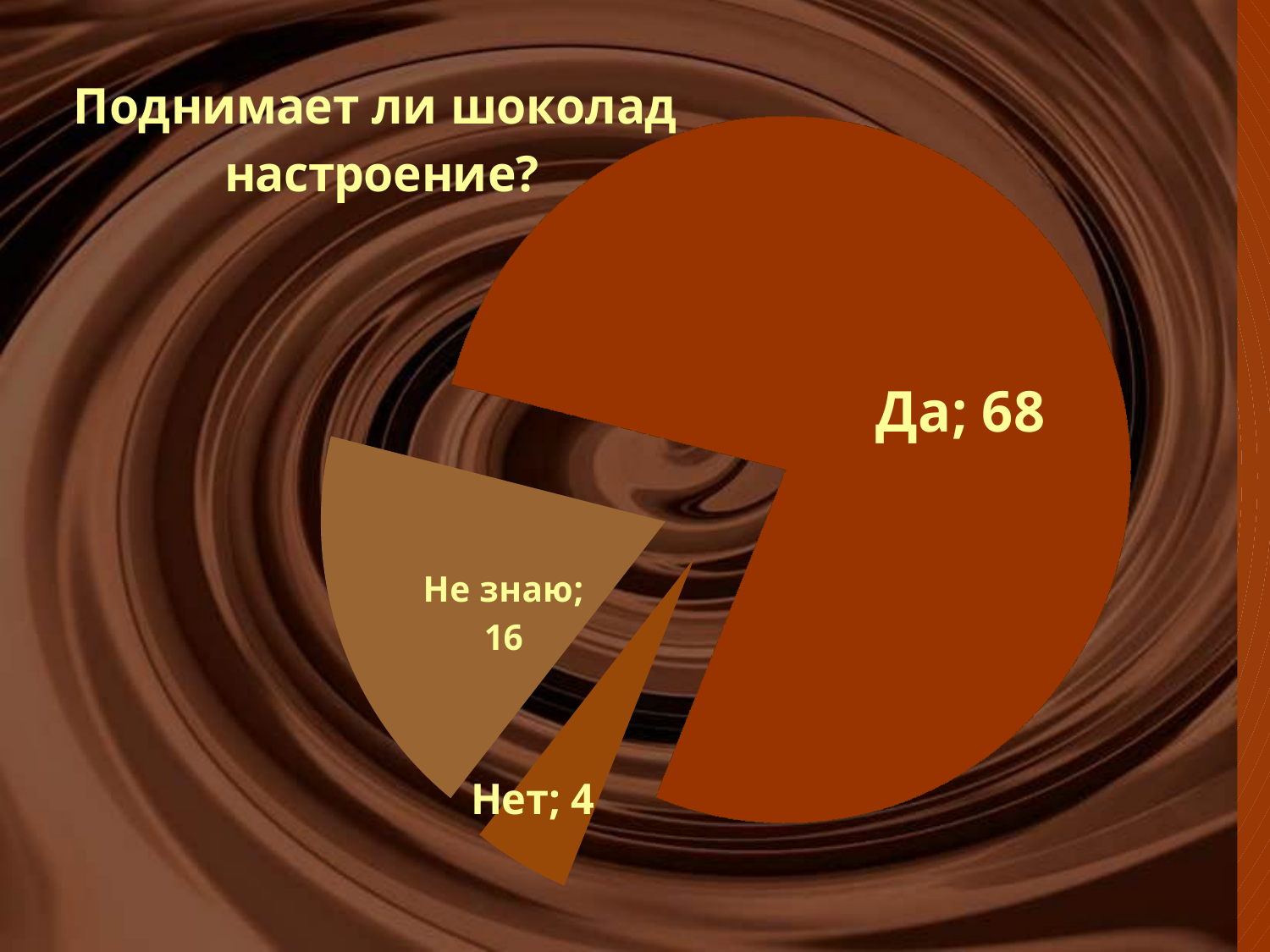
What is the title of the chart? Поднимает ли шоколад настроение? What is the value for the "Не знаю" slice? 16 What is the value for the "Да" slice? 68 What is the difference between the values for "Да" and "Не знаю"? 52 What is the value for the "Нет" slice? 4 Which is larger, the value for "Не знаю" or the value for "Нет"? Не знаю What kind of chart is shown on the slide? Pie chart Which slice has the largest value? Да What is the difference between the values for "Не знаю" and "Нет"? 12 What is the total of all the slice values in the pie chart? 88 Which slice has the smallest value? Нет How many slices does the pie chart have? 3